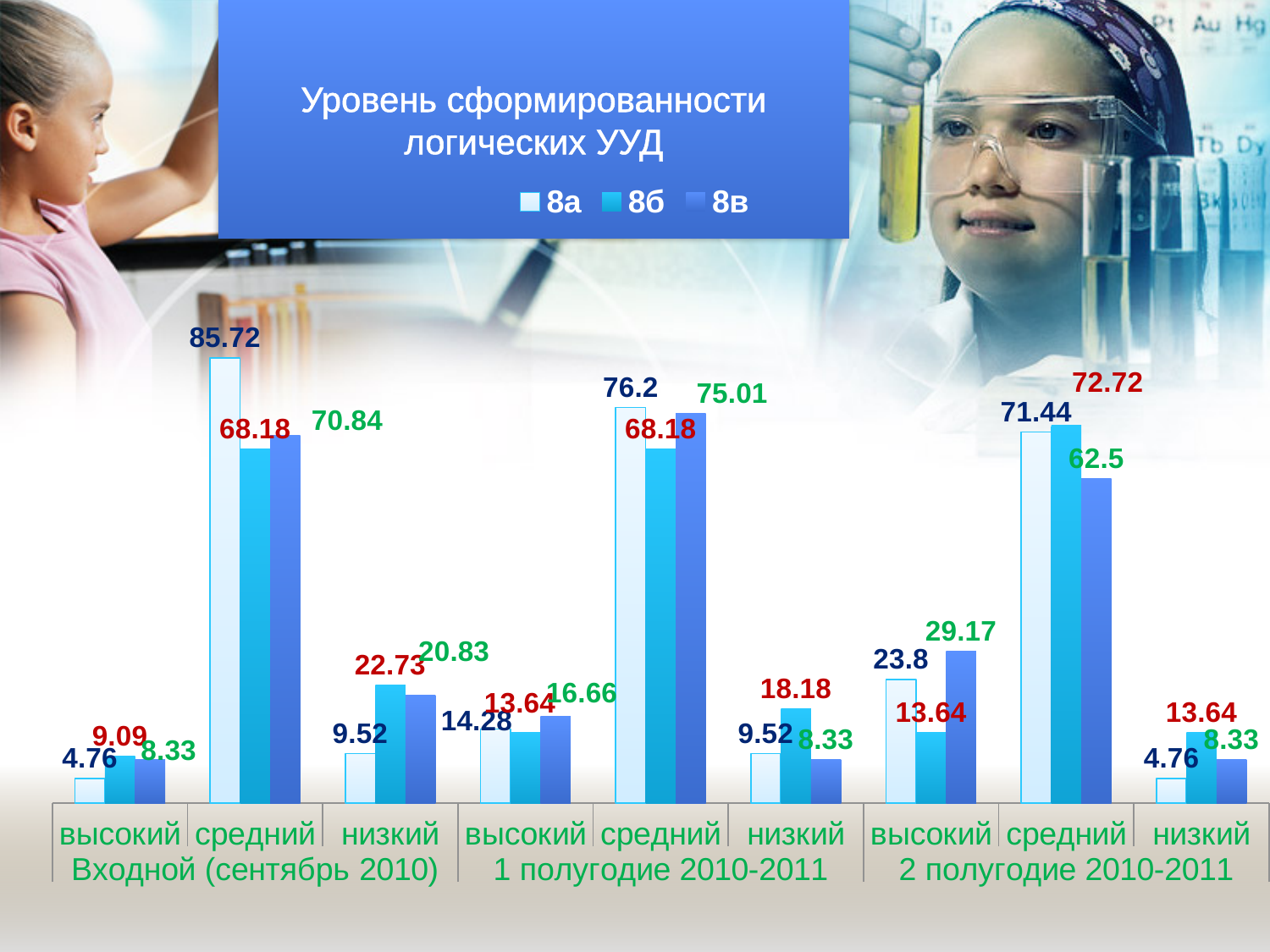
What is the difference between the 8а and 8б values in the средний category of 1 полугодие 2010-2011? 8.02 What is the value for 8в in the средний category of 2 полугодие 2010-2011? 62.5 Which is larger in the низкий category of Входной (сентябрь 2010): the value for 8б or the value for 8в? 8б How many series does the legend list? 3 What is the title of the chart? Уровень сформированности логических УУД What kind of chart is shown on the slide? bar chart What is the value for 8в in the высокий category of 2 полугодие 2010-2011? 29.17 How does the 8а value in the высокий category change from Входной (сентябрь 2010) to 2 полугодие 2010-2011? It rises Which series has the lowest value in the высокий category of 2 полугодие 2010-2011? 8б What is the value for 8а in the средний category of Входной (сентябрь 2010)? 85.72 What is the value for 8б in the низкий category of 1 полугодие 2010-2011? 18.18 Which series has the highest value in the средний category of Входной (сентябрь 2010)? 8а